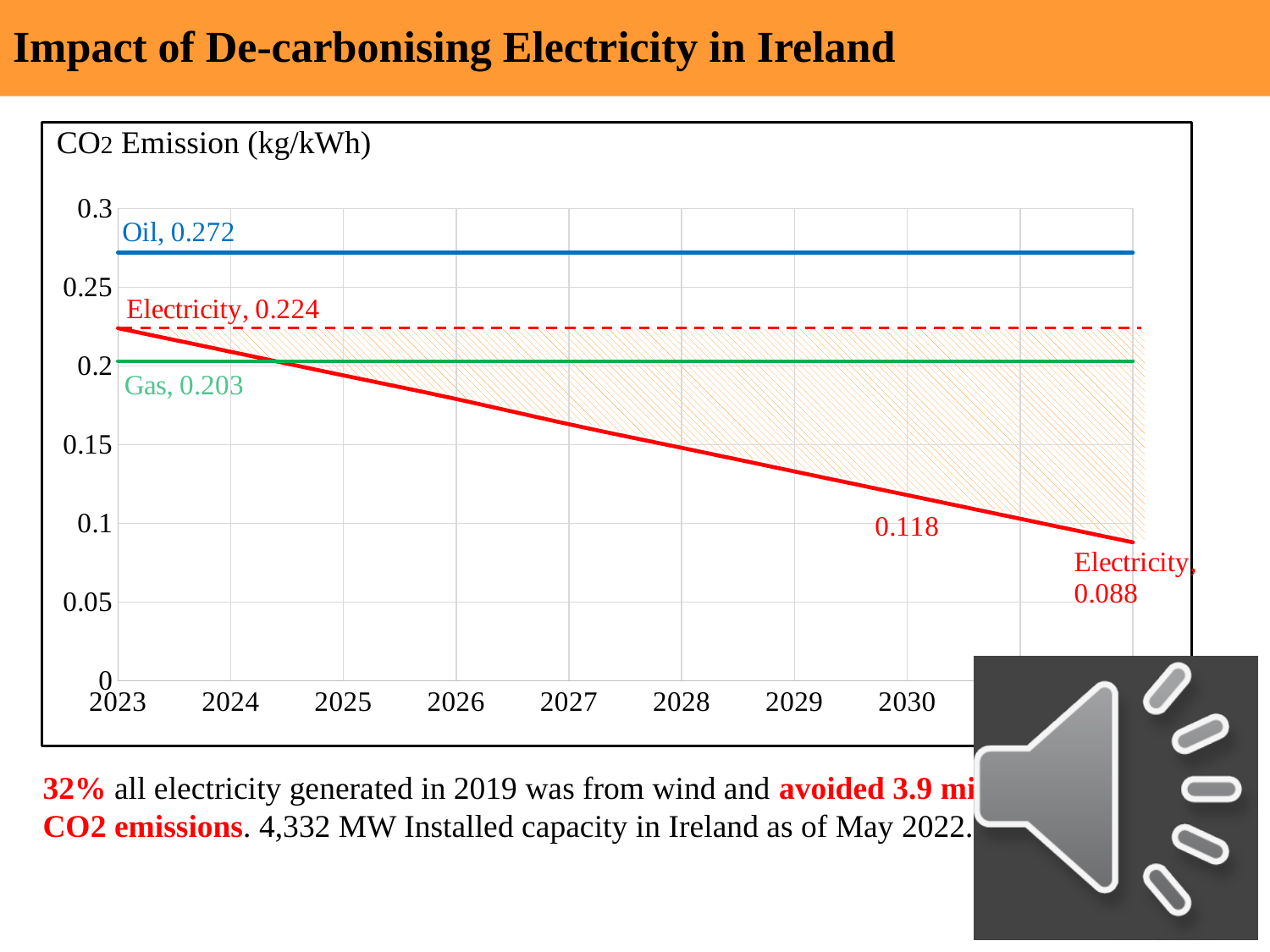
What is the CO2 emission value shown for Oil? 0.272 What is the final labelled value of the declining Electricity line at the right end of the chart? 0.088 Does the solid Electricity line rise or fall from 2023 onwards? fall Which fuel has the highest CO2 emission value on the chart? Oil What is the CO2 emission value shown for Gas? 0.203 Which is larger, the Gas value or the Electricity value in 2023? Electricity in 2023 By how much does the Electricity value fall from its 2023 value of 0.224 to its final value of 0.088? 0.136 What is the CO2 emission value for Electricity in 2023? 0.224 What is the title of the chart? CO2 Emission (kg/kWh) What kind of chart is shown on the slide? line chart What is the difference between the Oil value and the Gas value? 0.069 Is the value of the solid Electricity line in 2026 greater or less than 0.15? greater